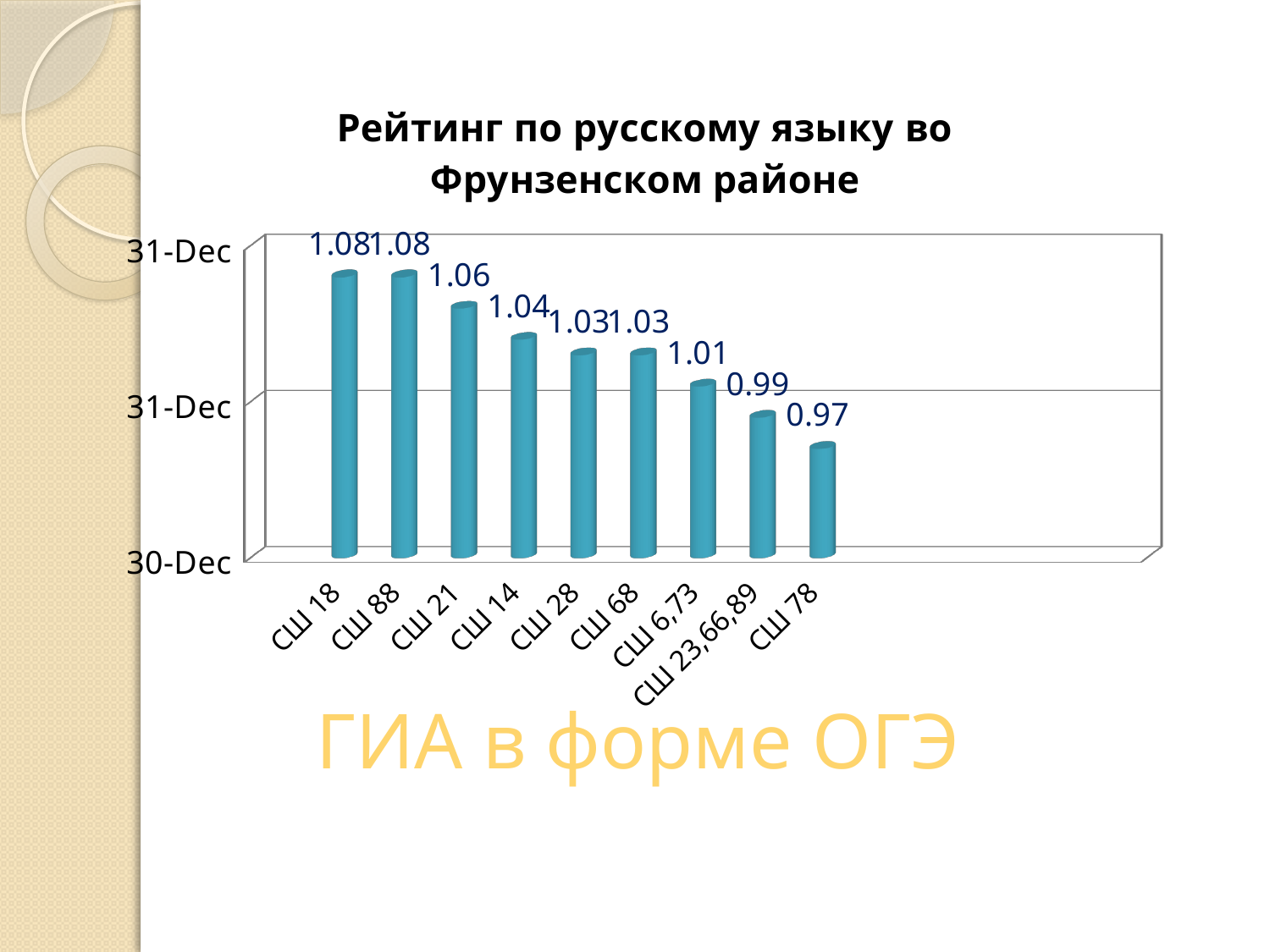
What kind of chart is this? bar chart How many categories are shown on the x axis? 9 What is the difference between the values for СШ 18 and СШ 78? 0.11 What is the value for СШ 18? 1.08 Which is larger, the value for СШ 21 or the value for СШ 28? СШ 21 What is the difference between the values for СШ 21 and СШ 14? 0.02 What is the value for СШ 78? 0.97 What is the value for СШ 23,66,89? 0.99 Which category has the lowest value? СШ 78 What is the value for СШ 21? 1.06 What is the value for СШ 6,73? 1.01 Do the values rise or fall from left to right along the x axis? fall